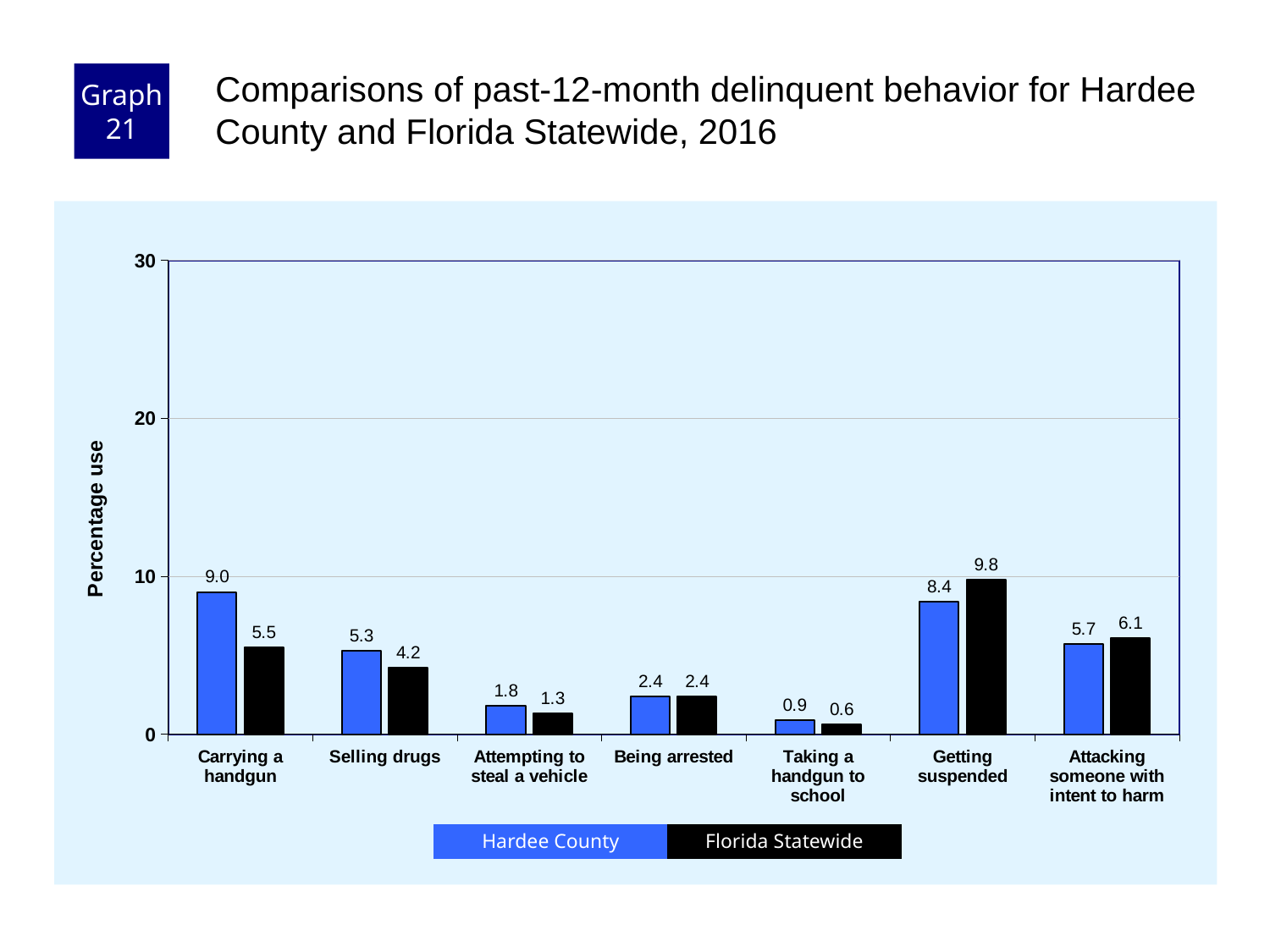
Which category has the lowest Hardee County value? Taking a handgun to school What kind of chart is shown on the slide? bar chart What is the Florida Statewide value for Getting suspended? 9.8 How many categories are shown on the x axis? 7 Is the Hardee County value for Getting suspended greater or less than 10? less How many series does the legend list? 2 Which category has the highest Florida Statewide value? Getting suspended What is the difference between the Hardee County and Florida Statewide values for Carrying a handgun? 3.5 Which is larger for Attacking someone with intent to harm, Hardee County or Florida Statewide? Florida Statewide What is the label of the y axis? Percentage use What is the Hardee County value for Carrying a handgun? 9.0 What is the Hardee County value for Taking a handgun to school? 0.9